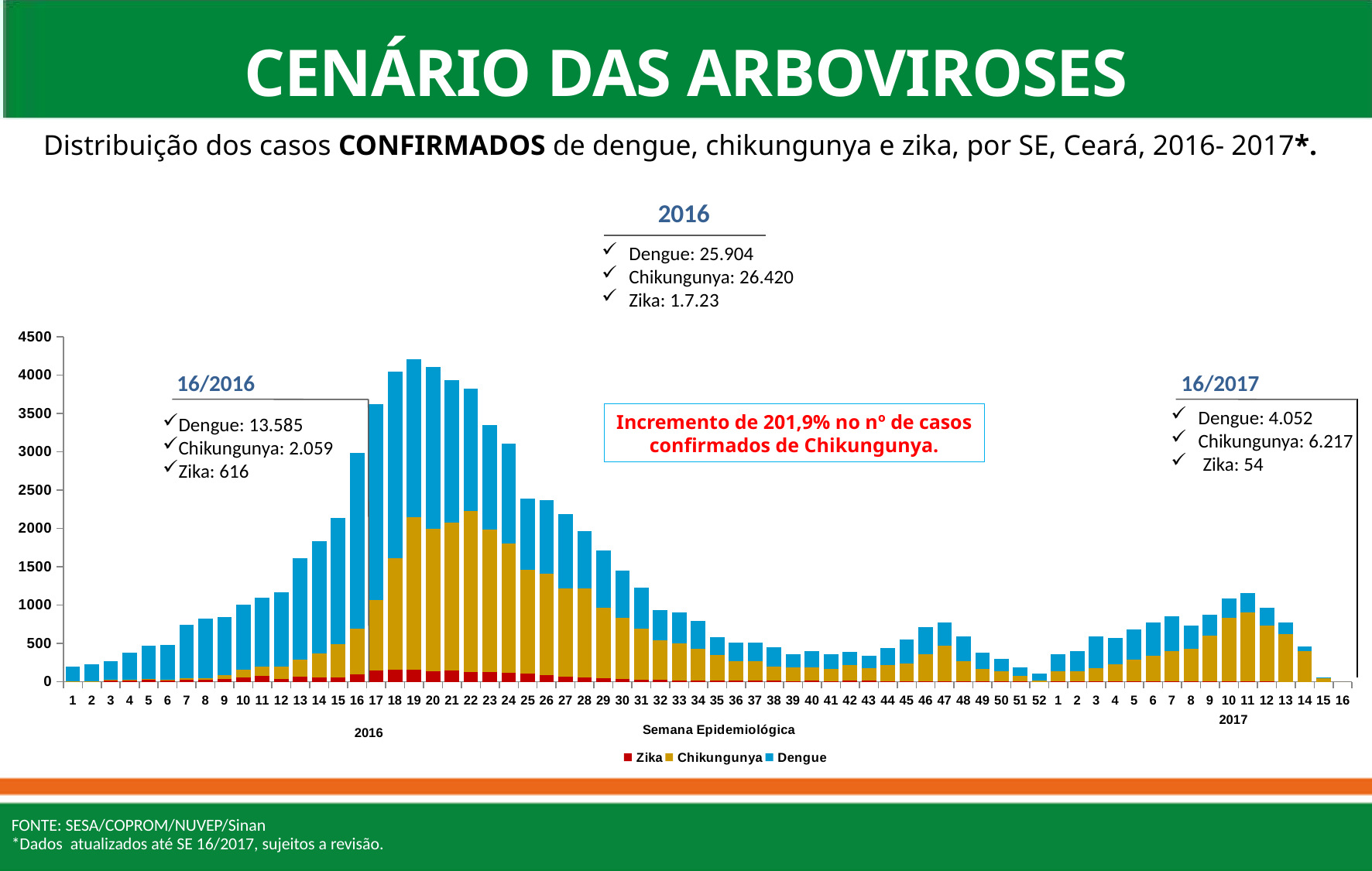
Which has a larger total of cases: week 19 of 2016 or week 11 of 2017? Week 19 of 2016 What kind of chart is shown on the slide? Stacked bar chart How many series does the chart legend list? 3 Which has a larger total of cases: week 10 of 2016 or week 40 of 2016? Week 10 of 2016 Is the total for week 52 of 2016 greater or less than 500? less Is the total for week 1 of 2016 greater or less than 500? less Which colour represents Dengue in the chart? Blue Is the total for week 19 of 2016 greater or less than 4000? greater Do the total cases rise or fall from week 19 to week 52 of 2016? Fall Which series are listed in the chart legend? Zika, Chikungunya, Dengue Which epidemiological week has the highest total of confirmed cases in the chart? Week 19 of 2016